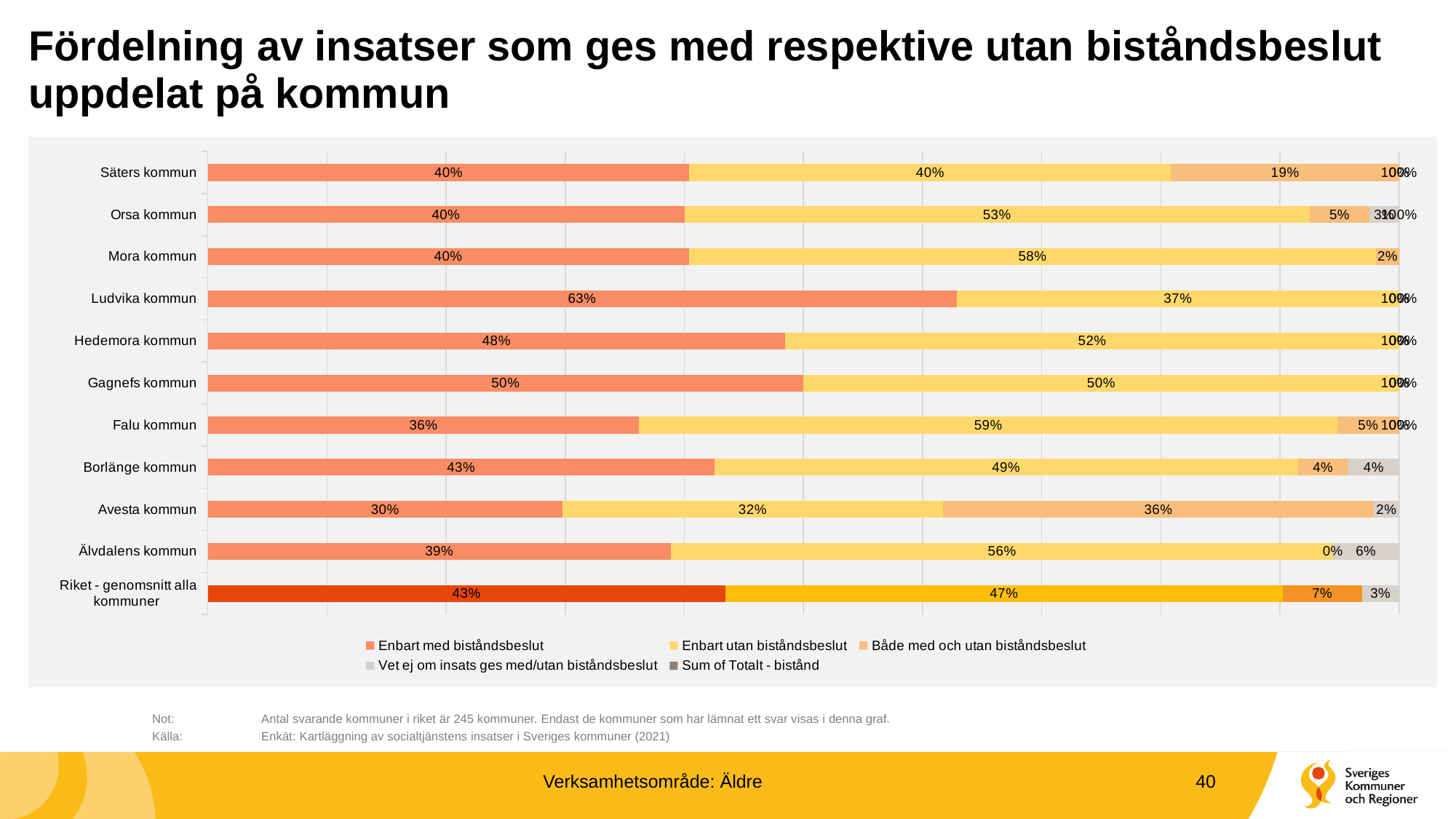
What is the value of 'Vet ej om insats ges med/utan biståndsbeslut' for Älvdalens kommun? 6% Which category has the lowest value for 'Enbart med biståndsbeslut'? Avesta kommun Which category has the highest value for 'Enbart med biståndsbeslut'? Ludvika kommun How many municipalities/categories are plotted on the chart? 11 What is the value of 'Enbart utan biståndsbeslut' for Riket - genomsnitt alla kommuner? 47% What is the difference between the 'Enbart med biståndsbeslut' values for Ludvika kommun and Avesta kommun? 33% What is the value of 'Enbart utan biståndsbeslut' for Mora kommun? 58% How many series does the legend list? 5 Which is larger: 'Enbart utan biståndsbeslut' for Hedemora kommun or for Ludvika kommun? Hedemora kommun What is the value of 'Enbart med biståndsbeslut' for Ludvika kommun? 63% What is the value of 'Både med och utan biståndsbeslut' for Avesta kommun? 36% What kind of chart is shown on the slide? Stacked bar chart